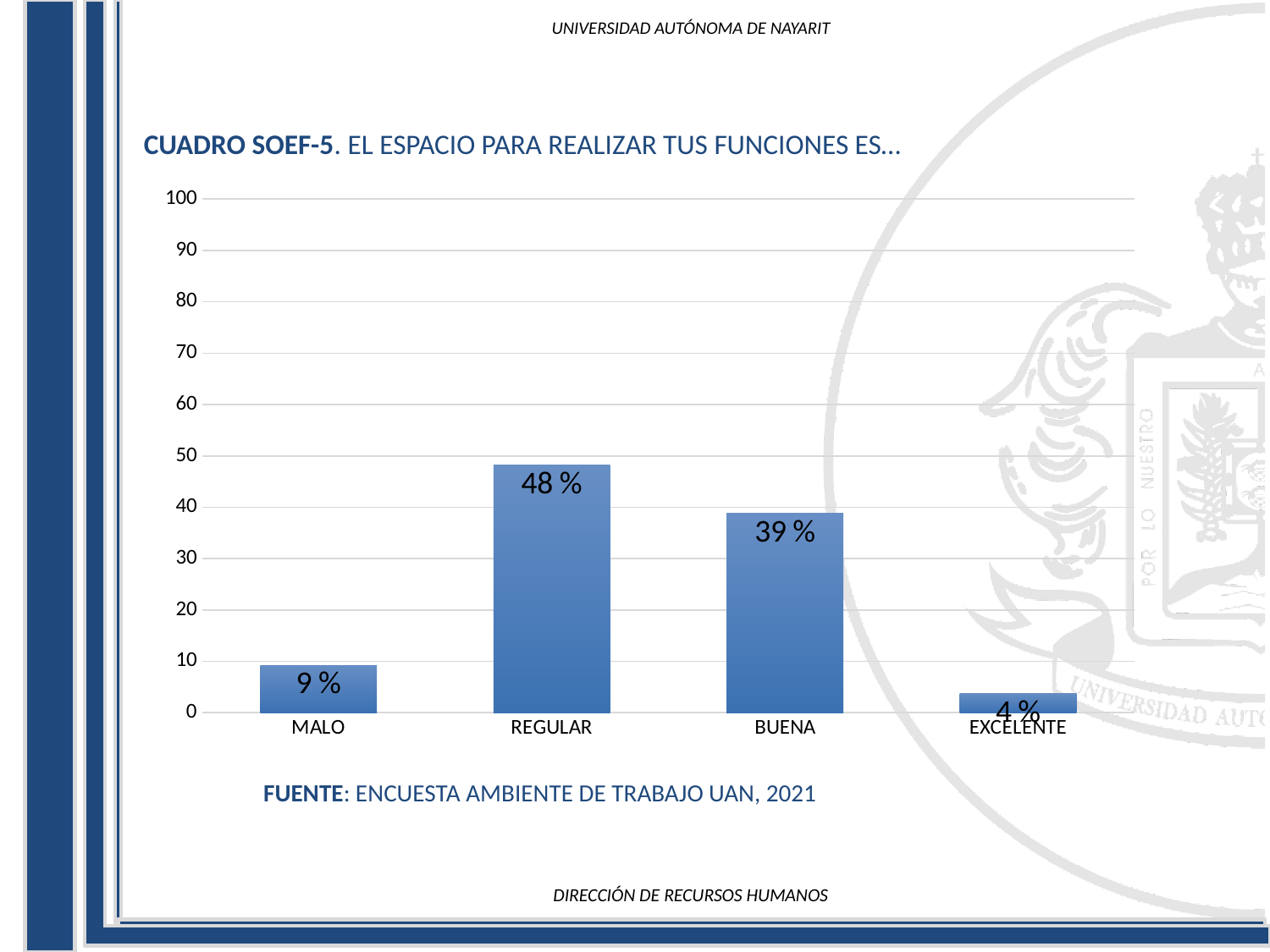
Which is larger, the value for MALO or the value for EXCELENTE? MALO What is the difference between the values for REGULAR and BUENA? 9 % What is the value for BUENA? 39 % Which category has the lowest value? EXCELENTE What kind of chart is shown on the slide? bar chart How many categories are shown on the x axis? 4 What is the value for EXCELENTE? 4 % Is the value for BUENA greater or less than 50? less What source is cited below the chart? ENCUESTA AMBIENTE DE TRABAJO UAN, 2021 Which category has the highest value? REGULAR What is the value for REGULAR? 48 % What is the value for MALO? 9 %